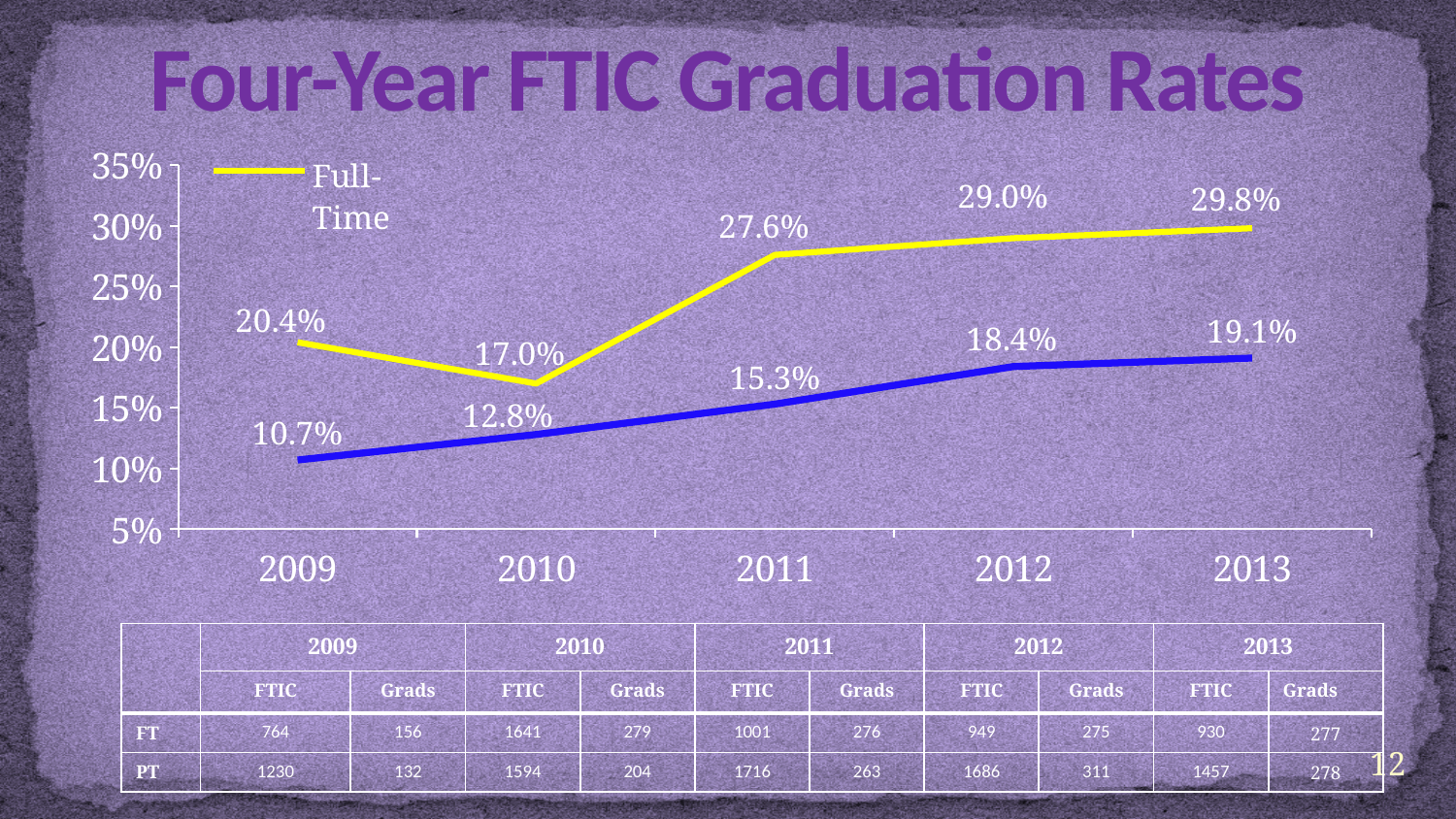
Which is larger in 2009, the Full-Time value or the blue line value? Full-Time How many years are shown on the x axis of the chart? 5 What is the difference between the Full-Time value and the blue line value in 2012? 10.6% What kind of chart is shown on the slide? line chart What is the Full-Time four-year graduation rate for 2011? 27.6% What value does the blue line show for 2009? 10.7% In which year is the Full-Time graduation rate highest? 2013 Is the blue line value for 2013 greater or less than 20%? less In which year is the Full-Time graduation rate lowest? 2010 Does the blue line rise or fall from 2009 to 2013? rise By how much did the Full-Time rate change from 2010 to 2011? 10.6% What is the Full-Time value for 2013? 29.8%